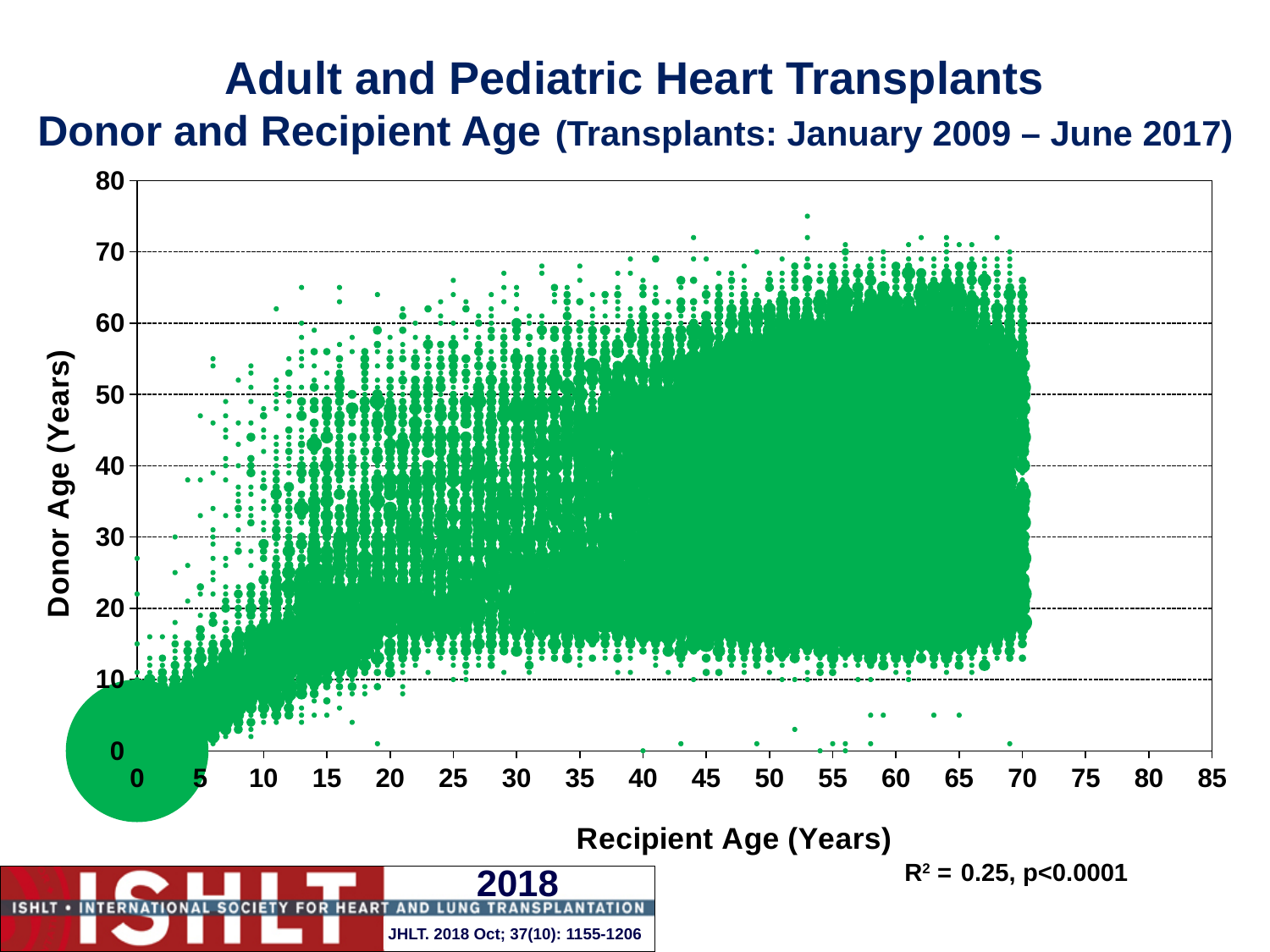
What is the label of the y axis? Donor Age (Years) What is the label of the x axis? Recipient Age (Years) Is the recipient age at which the dense cloud of bubbles ends greater or less than 75? less What R-squared value is reported for the relationship between donor and recipient age? R² = 0.25 What is the highest value shown on the y axis (Donor Age)? 80 Does donor age generally rise or fall as recipient age increases along the x axis? Rise How many data series are plotted on the chart? 1 What p-value is reported on the slide? p<0.0001 What is the highest value shown on the x axis (Recipient Age)? 85 At which recipient age and donor age is the largest bubble located? Recipient age 0, donor age 0 What kind of chart is shown on the slide? Bubble (scatter) chart What time period of transplants does the chart cover? January 2009 – June 2017